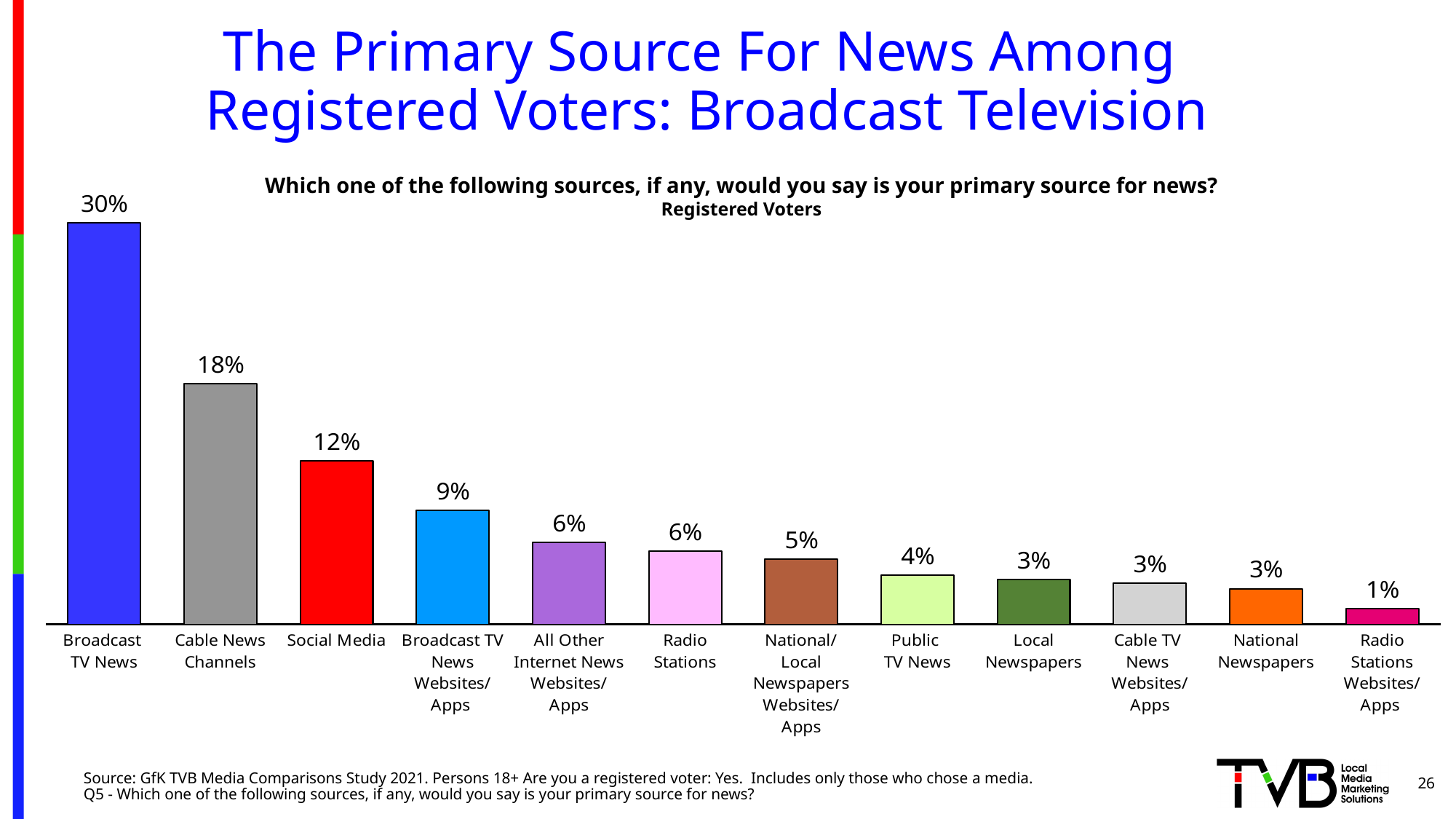
What is the difference between the values for Broadcast TV News and Cable News Channels? 12% Which is larger, the value for Social Media or the value for Broadcast TV News Websites/Apps? Social Media What is the value shown for Cable News Channels? 18% What is the value shown for Public TV News? 4% Which category has the lowest value in the chart? Radio Stations Websites/Apps What kind of chart is shown on the slide? Bar chart Do the values rise or fall moving from left to right along the x axis? Fall What percentage of registered voters named Broadcast TV News as their primary source for news? 30% What is the value shown for Social Media? 12% What is the difference between the values for Radio Stations and National Newspapers? 3% How many categories are shown in the chart? 12 Which category has the highest value in the chart? Broadcast TV News